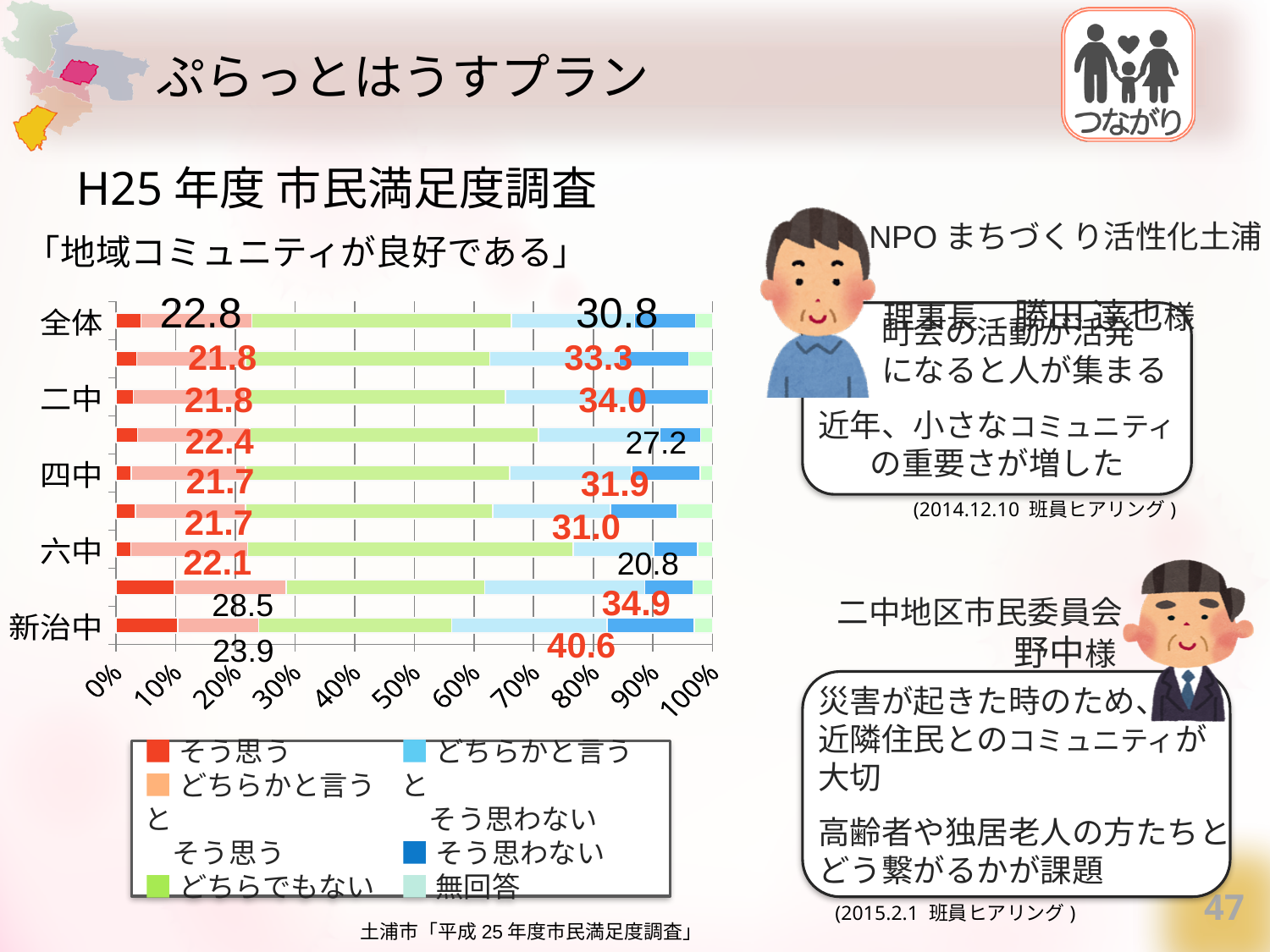
What is the difference between the right-segment value (30.8) and the left-segment value (22.8) printed on the 全体 bar? 8.0 What value is printed on the left part (light-orange segment) of the 六中 bar? 22.1 How many entries does the chart's legend list? 6 What value is printed on the right part (light-blue segment) of the 新治中 bar? 40.6 What value is printed on the left part (light-orange segment) of the 全体 bar? 22.8 What value is printed on the right part (light-blue segment) of the 全体 bar? 30.8 What value is printed on the right part (light-blue segment) of the 二中 bar? 34.0 What kind of chart is shown on the slide? Stacked bar chart What survey statement is the chart about, as quoted above the chart? 地域コミュニティが良好である Which has the larger value printed on its right (light-blue) segment, 二中 or 四中? 二中 Among the labelled categories 全体, 二中, 四中, 六中 and 新治中, which has the highest value printed on the right (light-blue) segment? 新治中 Among the labelled categories 全体, 二中, 四中, 六中 and 新治中, which has the lowest value printed on the right (light-blue) segment? 六中